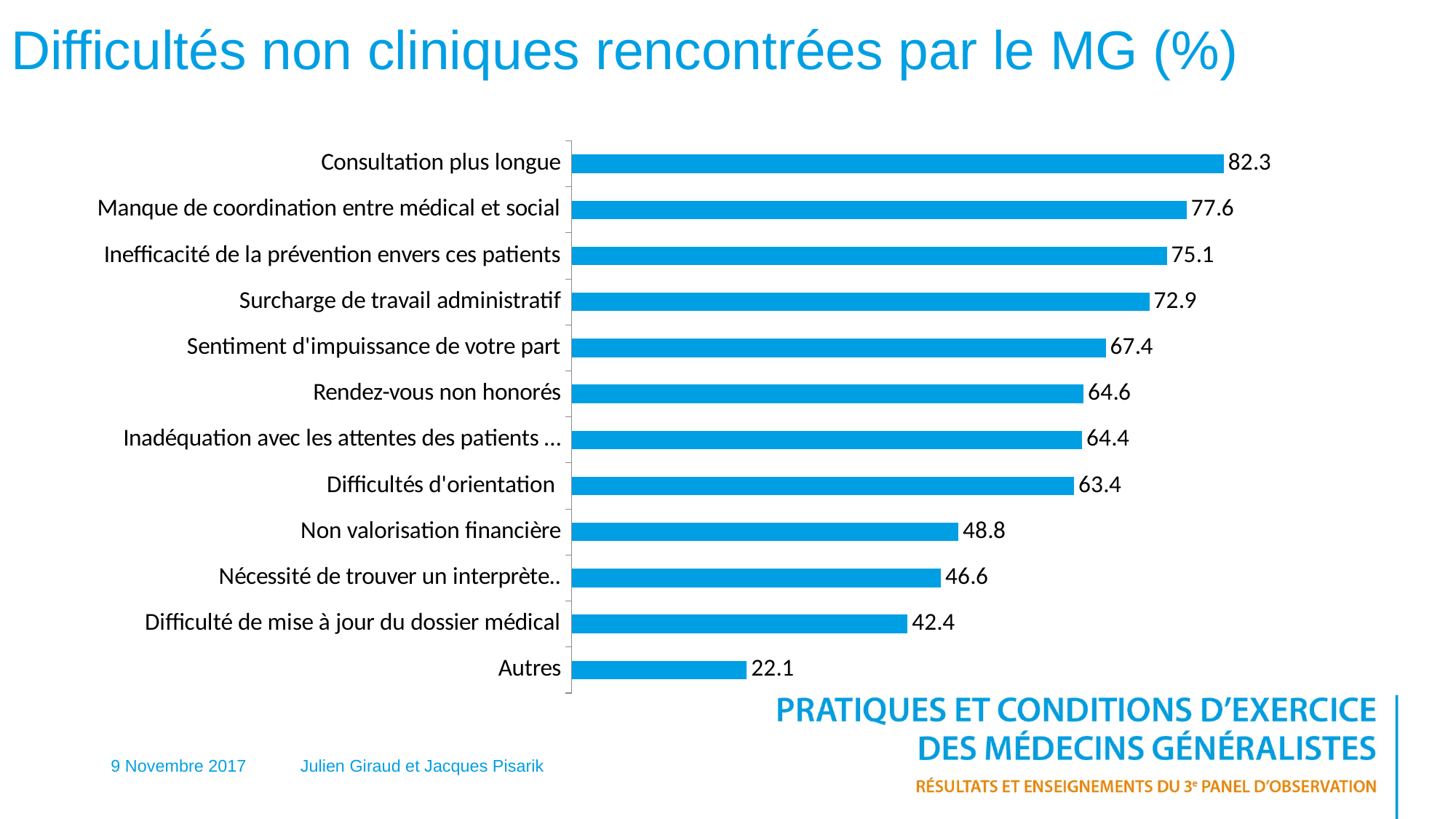
What is the difference between "Non valorisation financière" and "Difficulté de mise à jour du dossier médical"? 6.4 What is the difference between "Consultation plus longue" and "Manque de coordination entre médical et social"? 4.7 What is the value for "Rendez-vous non honorés"? 64.6 Which is larger: "Sentiment d'impuissance de votre part" or "Difficultés d'orientation"? Sentiment d'impuissance de votre part What is the value for "Consultation plus longue"? 82.3 How many categories are shown in the chart? 12 What kind of chart is shown on the slide? Bar chart What is the value for "Surcharge de travail administratif"? 72.9 Which category has the highest value? Consultation plus longue Which category has the lowest value? Autres What is the value for "Autres"? 22.1 What is the title of the slide? Difficultés non cliniques rencontrées par le MG (%)